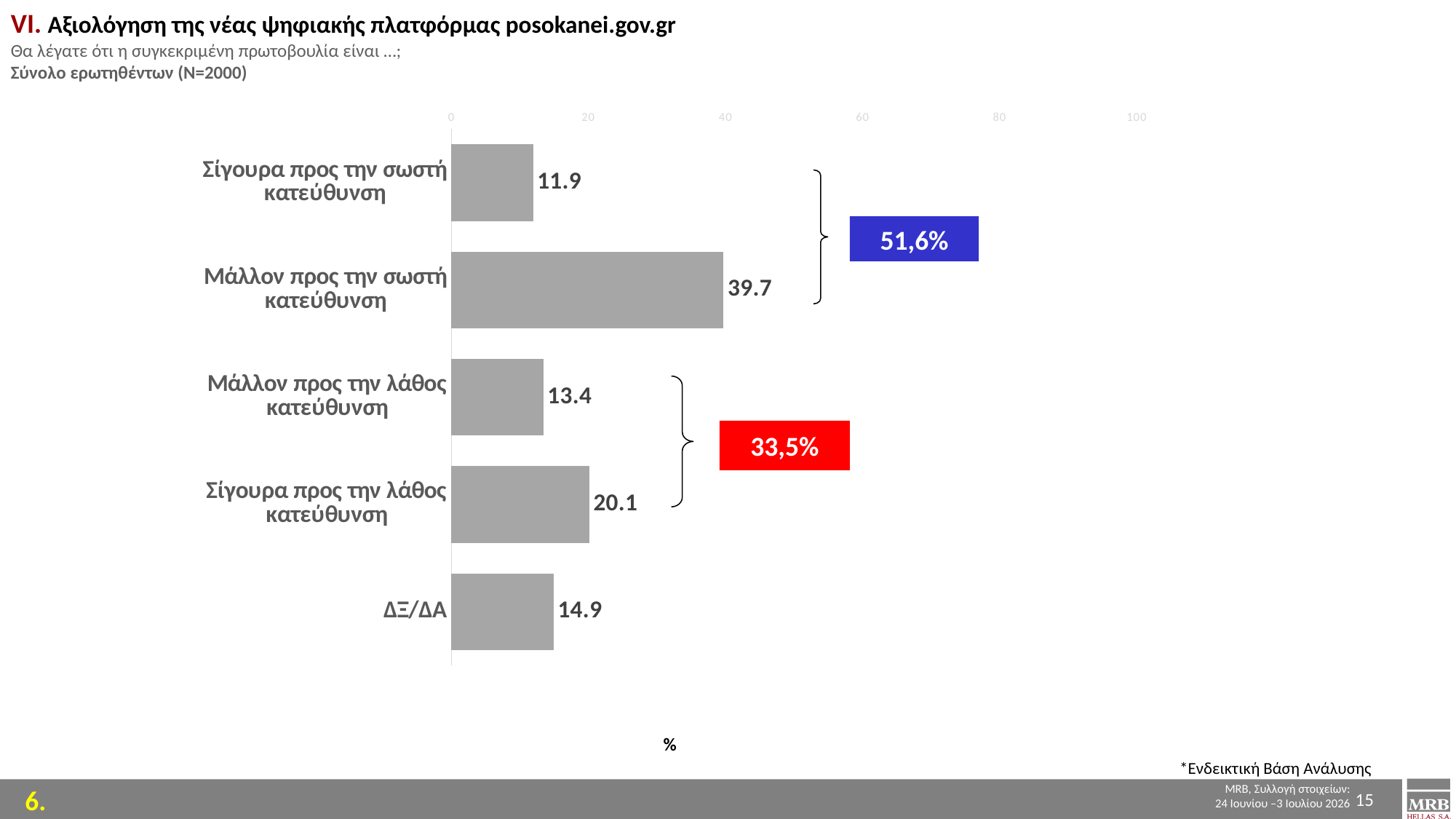
Which category has the lowest value? Σίγουρα προς την σωστή κατεύθυνση What is the difference between the values for "Μάλλον προς την σωστή κατεύθυνση" and "Σίγουρα προς την σωστή κατεύθυνση"? 27.8 What kind of chart is shown on the slide? bar chart What is the value for "Μάλλον προς την σωστή κατεύθυνση"? 39.7 Is the value for "Σίγουρα προς την λάθος κατεύθυνση" greater or less than 40? less Which is larger: the value for "Μάλλον προς την λάθος κατεύθυνση" or the value for "ΔΞ/ΔΑ"? ΔΞ/ΔΑ What combined percentage is shown in the blue box for the two "σωστή κατεύθυνση" categories? 51,6% What is the value for "Σίγουρα προς την λάθος κατεύθυνση"? 20.1 What combined percentage is shown in the red box for the two "λάθος κατεύθυνση" categories? 33,5% How many categories are shown in the chart? 5 What is the value for "ΔΞ/ΔΑ"? 14.9 Which category has the highest value? Μάλλον προς την σωστή κατεύθυνση